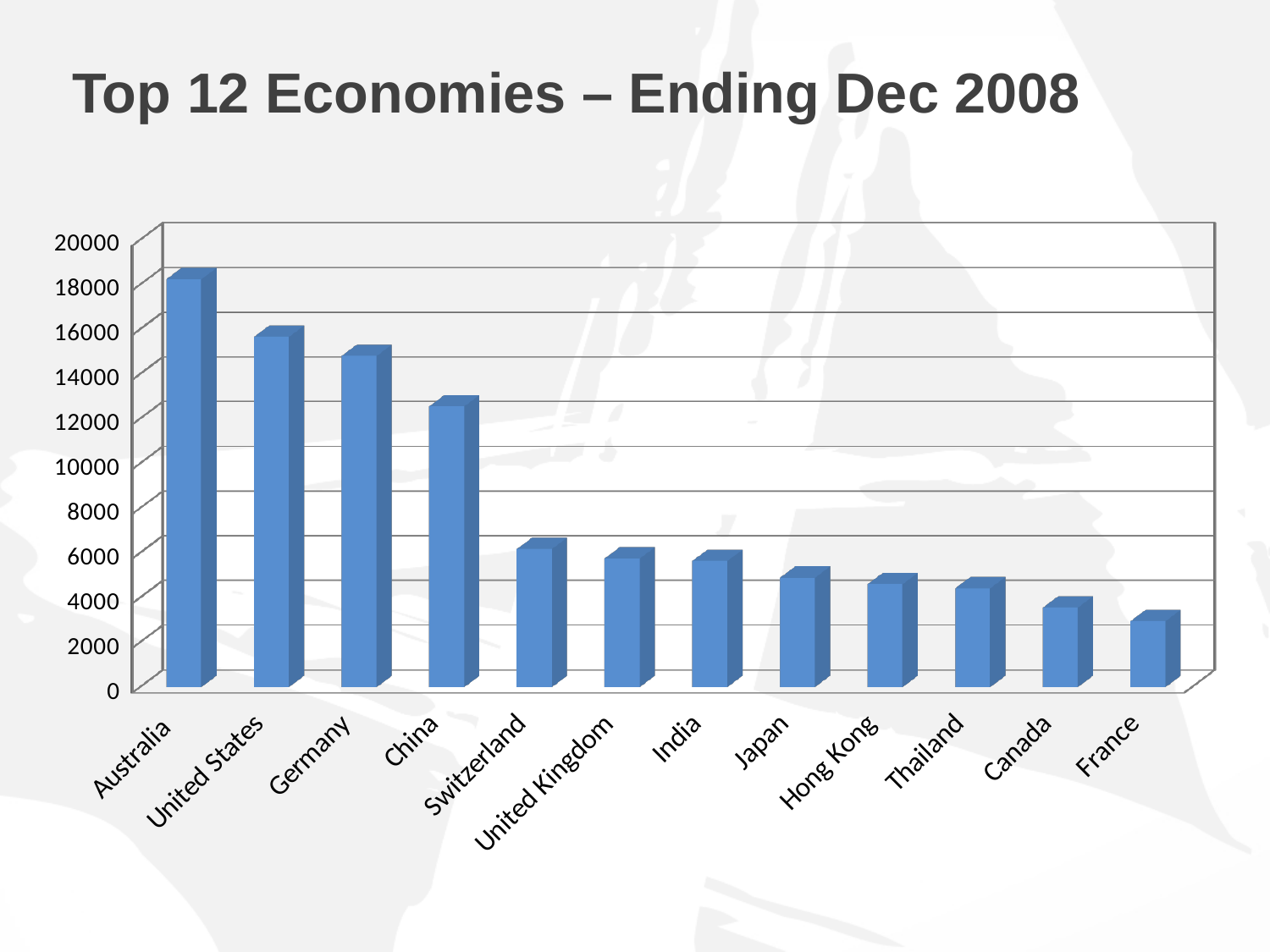
Which country has the lowest value on the chart? France Is the value for China greater or less than 14000? less Is the value for Germany greater or less than 12000? greater Is the value for Switzerland greater or less than 4000? greater Which is larger, the value for Australia or the value for China? Australia Do the values rise or fall moving from left to right along the x axis? Fall What is the title of the slide? Top 12 Economies – Ending Dec 2008 Which country has the highest value on the chart? Australia What kind of chart is shown on the slide? Bar chart How many countries are plotted on the chart? 12